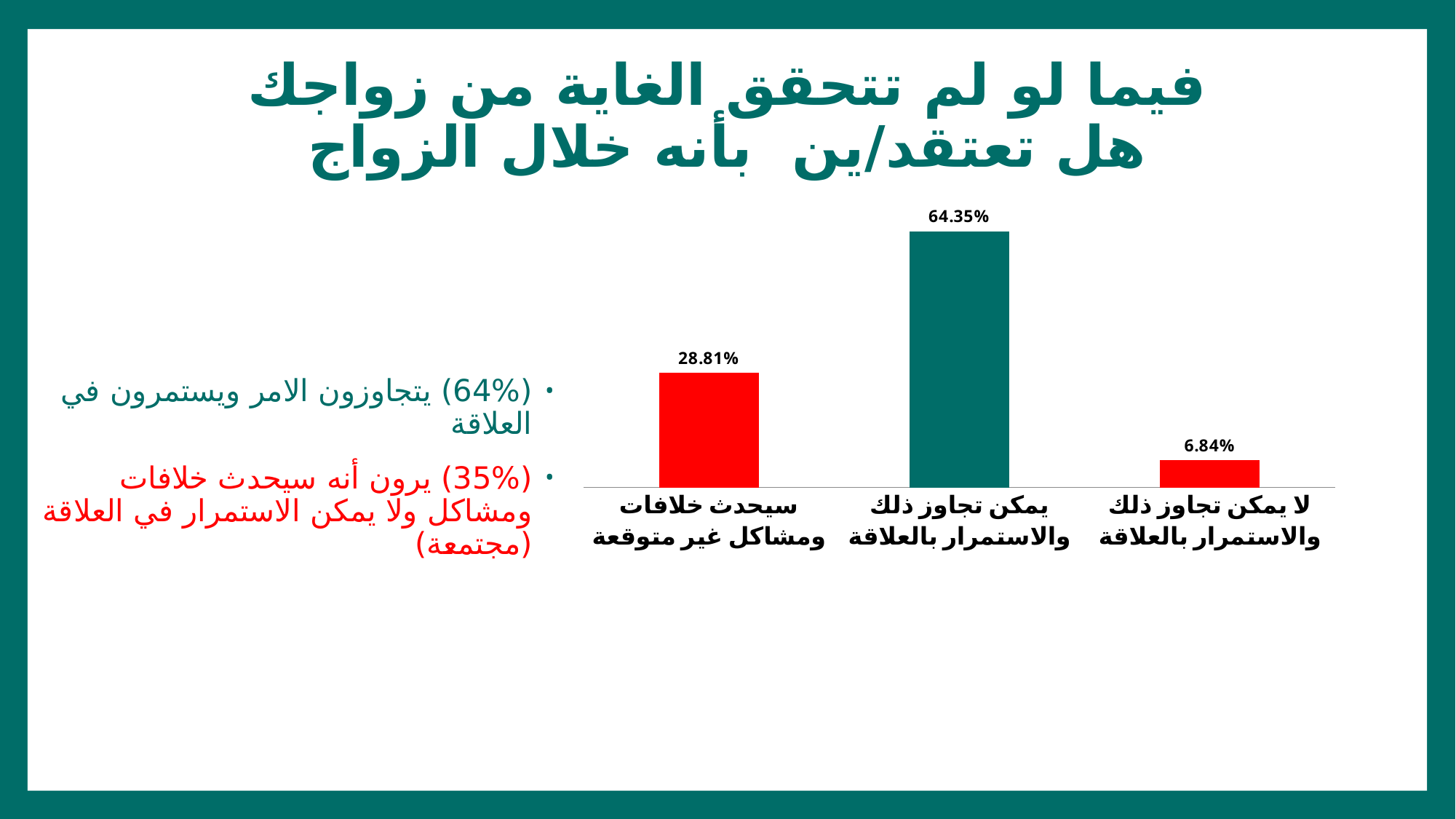
What value is shown for the category "يمكن تجاوز ذلك والاستمرار بالعلاقة"? 64.35% What value is shown for the category "لا يمكن تجاوز ذلك والاستمرار بالعلاقة"? 6.84% What is the difference between the values for "يمكن تجاوز ذلك والاستمرار بالعلاقة" and "سيحدث خلافات ومشاكل غير متوقعة"? 35.54% What colour is the bar for "يمكن تجاوز ذلك والاستمرار بالعلاقة"? Dark green (teal) What kind of chart is shown on the slide? Bar chart Which category has the highest value in the chart? يمكن تجاوز ذلك والاستمرار بالعلاقة Which category has the lowest value in the chart? لا يمكن تجاوز ذلك والاستمرار بالعلاقة What is the difference between the values for "سيحدث خلافات ومشاكل غير متوقعة" and "لا يمكن تجاوز ذلك والاستمرار بالعلاقة"? 21.97% How many categories are shown in the chart? 3 How many bars in the chart are red? 2 What value is shown for the category "سيحدث خلافات ومشاكل غير متوقعة"? 28.81% Which is larger: the value for "سيحدث خلافات ومشاكل غير متوقعة" or the value for "لا يمكن تجاوز ذلك والاستمرار بالعلاقة"? سيحدث خلافات ومشاكل غير متوقعة